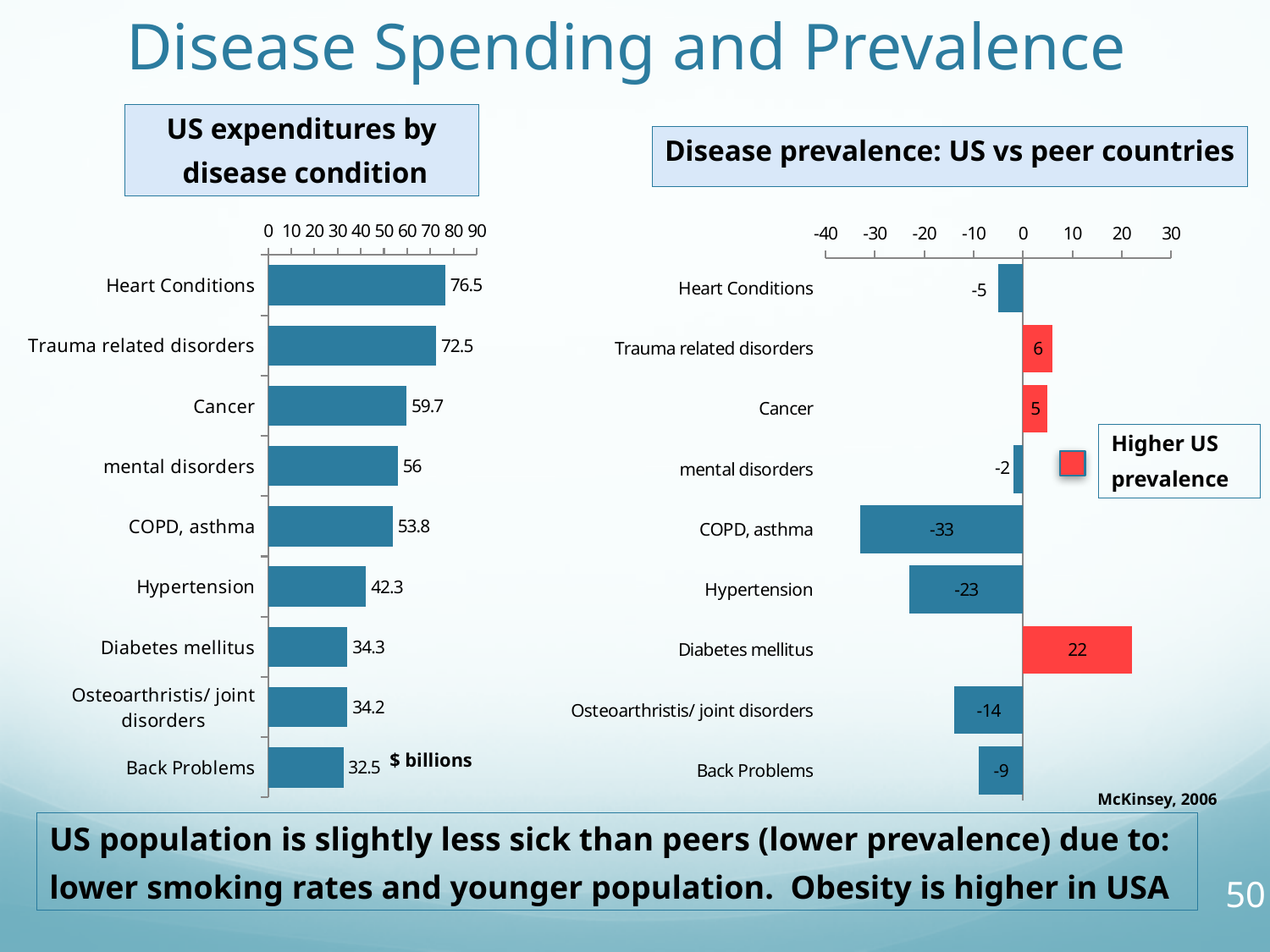
In the 'US expenditures by disease condition' chart, which disease condition has the highest expenditure? Heart Conditions In the 'Disease prevalence: US vs peer countries' chart, which is larger, the value for Hypertension or the value for Osteoarthristis/ joint disorders? Osteoarthristis/ joint disorders In the 'US expenditures by disease condition' chart, what is the difference between the values for Heart Conditions and Trauma related disorders? 4 In the 'Disease prevalence: US vs peer countries' chart, what do the red bars indicate? Higher US prevalence In the 'Disease prevalence: US vs peer countries' chart, what is the value for COPD, asthma? -33 In the 'US expenditures by disease condition' chart, which disease condition has the lowest expenditure? Back Problems In the 'Disease prevalence: US vs peer countries' chart, what is the difference between the values for Trauma related disorders and Cancer? 1 What type of chart is the 'US expenditures by disease condition' chart? Bar chart In the 'Disease prevalence: US vs peer countries' chart, what is the value for Diabetes mellitus? 22 In the 'US expenditures by disease condition' chart, how many disease conditions are shown? 9 In the 'Disease prevalence: US vs peer countries' chart, which condition has the lowest value? COPD, asthma In the 'US expenditures by disease condition' chart, what is the value for Cancer? 59.7